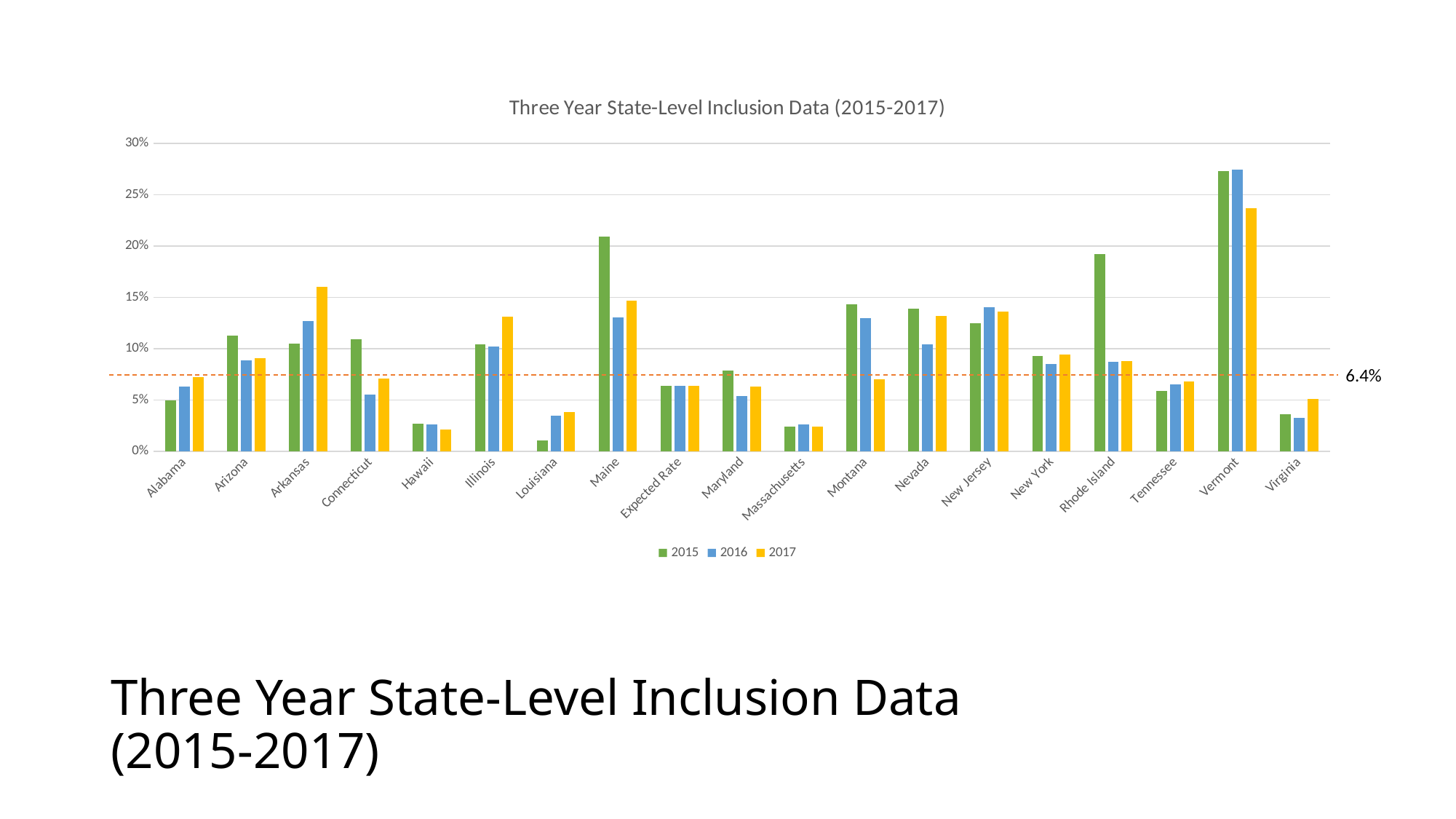
Is the 2017 value for Arkansas greater or less than 15%? greater Is the 2015 value for Maine greater or less than 20%? greater Which state has the lowest 2015 value? Louisiana How many categories are shown along the x axis? 19 Which state has the highest 2015 value? Vermont What value is labelled on the dashed horizontal reference line? 6.4% Which is larger, the 2015 value for Rhode Island or the 2017 value for Rhode Island? 2015 Do the values for Arkansas rise or fall from 2015 to 2017? rise What is the title of the chart? Three Year State-Level Inclusion Data (2015-2017) Is the 2017 value for Hawaii greater or less than 5%? less How many series does the legend list? 3 What kind of chart is shown on the slide? bar chart